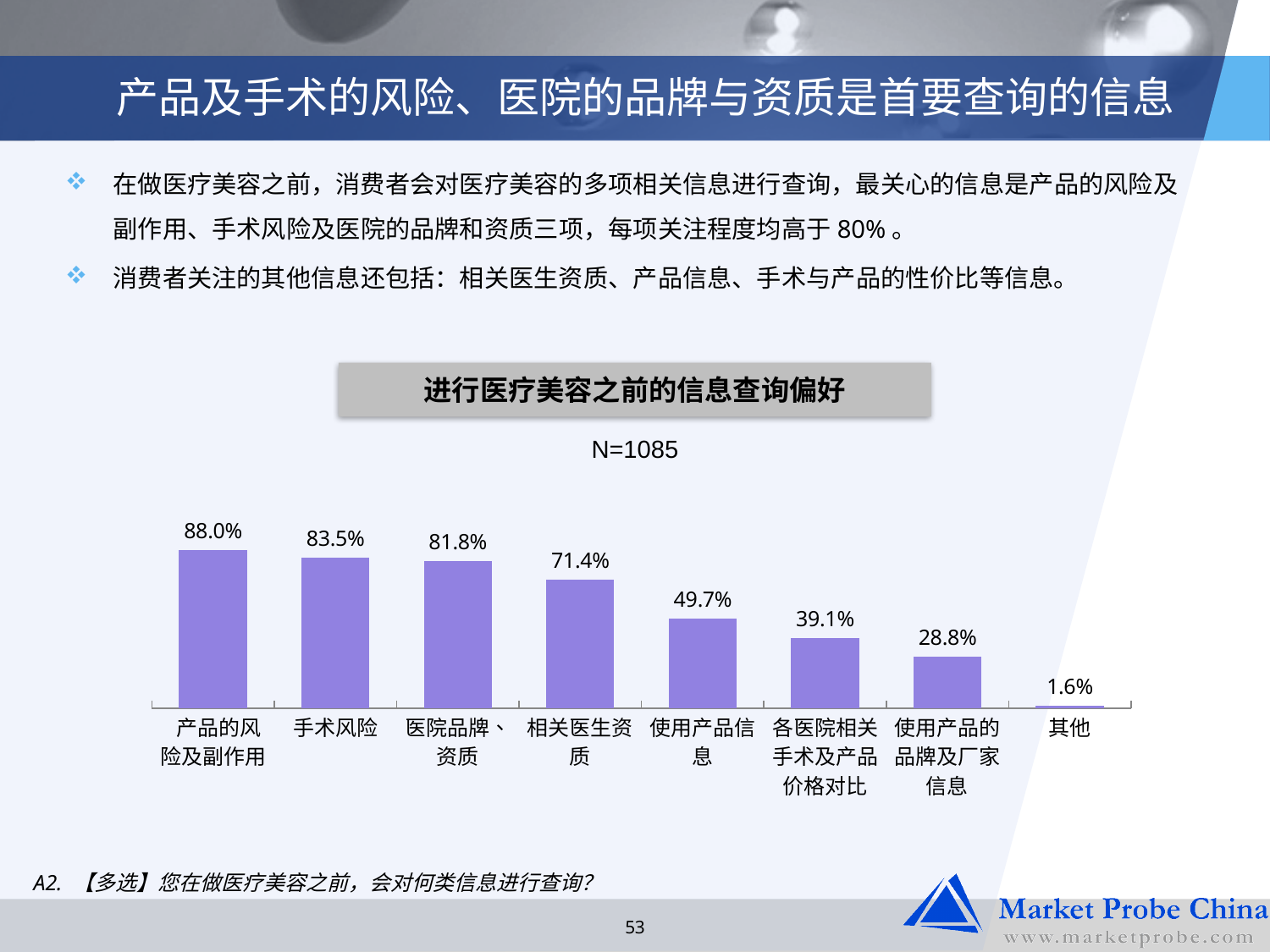
What is the difference between the values for 使用产品信息 and 各医院相关手术及产品价格对比? 10.6% What is the value for 产品的风险及副作用? 88.0% What kind of chart is shown on the slide? bar chart Which category has the highest value? 产品的风险及副作用 Which is larger, the value for 医院品牌、资质 or the value for 相关医生资质? 医院品牌、资质 What is the value for 使用产品的品牌及厂家信息? 28.8% What is the value for 手术风险? 83.5% What is the difference between the values for 产品的风险及副作用 and 手术风险? 4.5% How many categories are shown in the chart? 8 What is the sample size (N) shown for the chart? N=1085 What is the value for 相关医生资质? 71.4% Which category has the lowest value? 其他